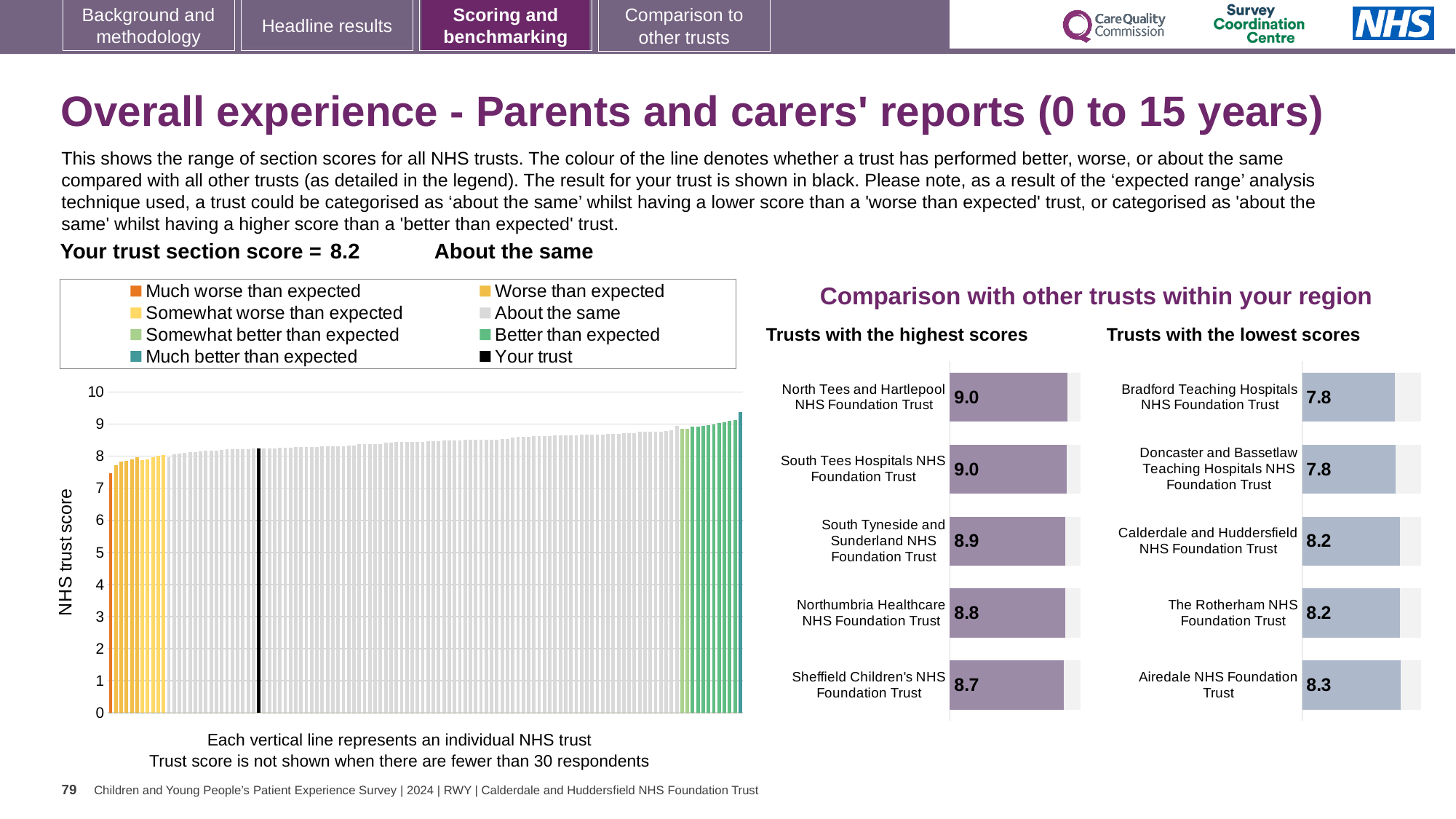
In the 'Trusts with the lowest scores' chart, what is the difference between the scores of Airedale NHS Foundation Trust and Bradford Teaching Hospitals NHS Foundation Trust? 0.5 In the 'Trusts with the lowest scores' chart, what is the score for Airedale NHS Foundation Trust? 8.3 In the 'Trusts with the highest scores' chart, what is the score for Northumbria Healthcare NHS Foundation Trust? 8.8 How many trusts are shown in the 'Trusts with the lowest scores' chart? 5 In the 'Trusts with the lowest scores' chart, which trust has the highest score? Airedale NHS Foundation Trust How many entries does the legend of the NHS trust score chart on the left list? 8 In the 'Trusts with the highest scores' chart, which trust has the lowest score? Sheffield Children's NHS Foundation Trust In the 'Trusts with the highest scores' chart, what is the score for Sheffield Children's NHS Foundation Trust? 8.7 In the 'Trusts with the lowest scores' chart, is the value for Bradford Teaching Hospitals NHS Foundation Trust greater or less than 8? less What kind of chart is the NHS trust score chart on the left of the slide? Bar chart In the 'Trusts with the highest scores' chart, what is the difference between the scores of North Tees and Hartlepool NHS Foundation Trust and Sheffield Children's NHS Foundation Trust? 0.3 In the 'Trusts with the highest scores' chart, which has the higher score: South Tyneside and Sunderland NHS Foundation Trust or Northumbria Healthcare NHS Foundation Trust? South Tyneside and Sunderland NHS Foundation Trust